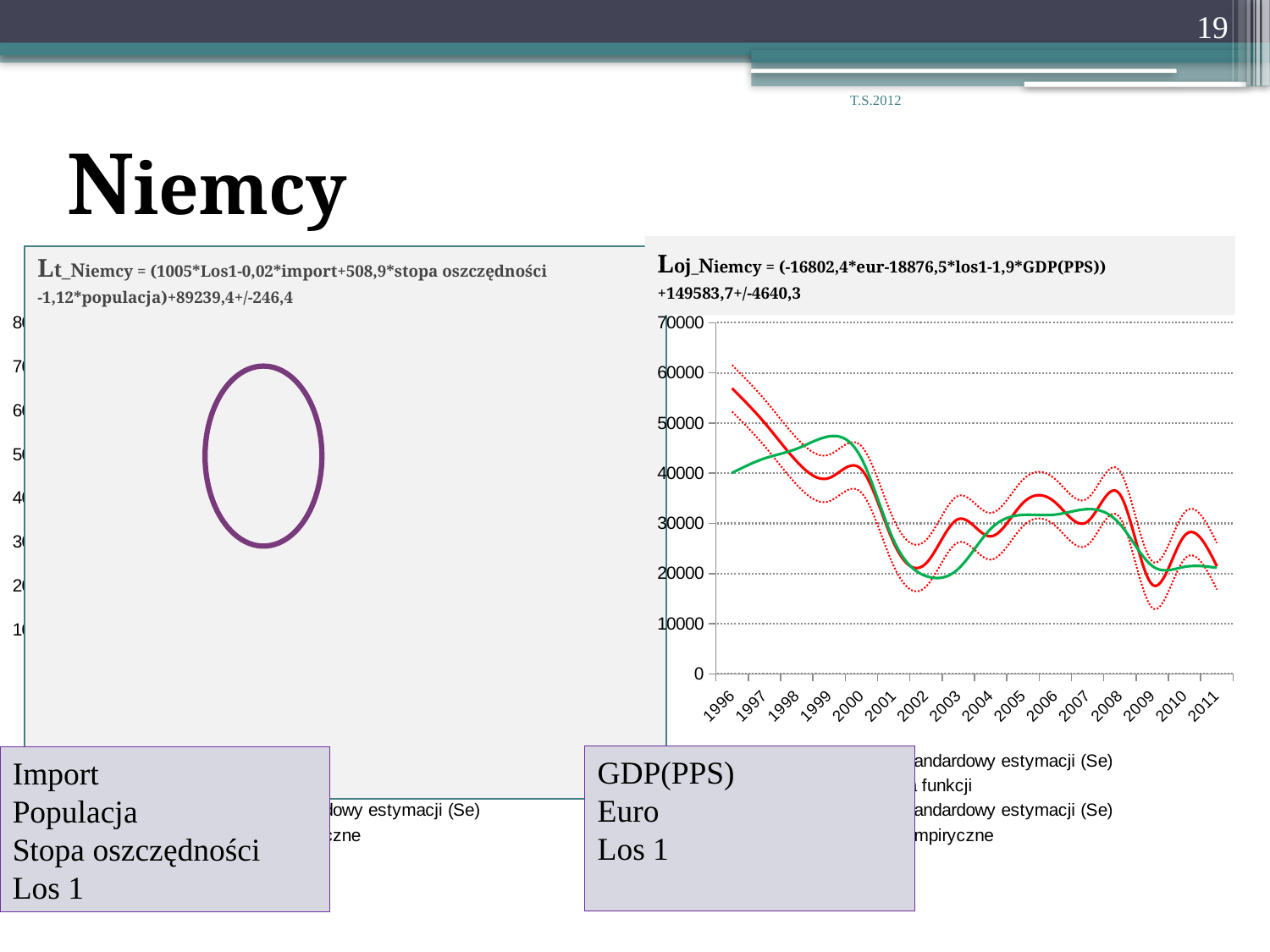
What kind of chart is the right-hand chart titled Loj_Niemcy? line chart In the Loj_Niemcy chart, what is the highest value labelled on the y axis? 70000 In the Loj_Niemcy chart, is the value of the green line in 2000 greater or less than 40000? greater In the Loj_Niemcy chart, is the value of the solid red line in 2009 greater or less than 20000? less In the Loj_Niemcy chart, is the solid red line higher in 1996 or in 2011? 1996 In the Loj_Niemcy chart, is the value of the solid red line in 2008 greater or less than 30000? greater In the Loj_Niemcy chart, how many years are shown on the x axis? 16 In the Loj_Niemcy chart, what is the first year on the x axis? 1996 In the Loj_Niemcy chart, does the solid red line overall rise or fall from 1996 to 2011? fall In the Loj_Niemcy chart, is the green line higher in 2000 or in 2002? 2000